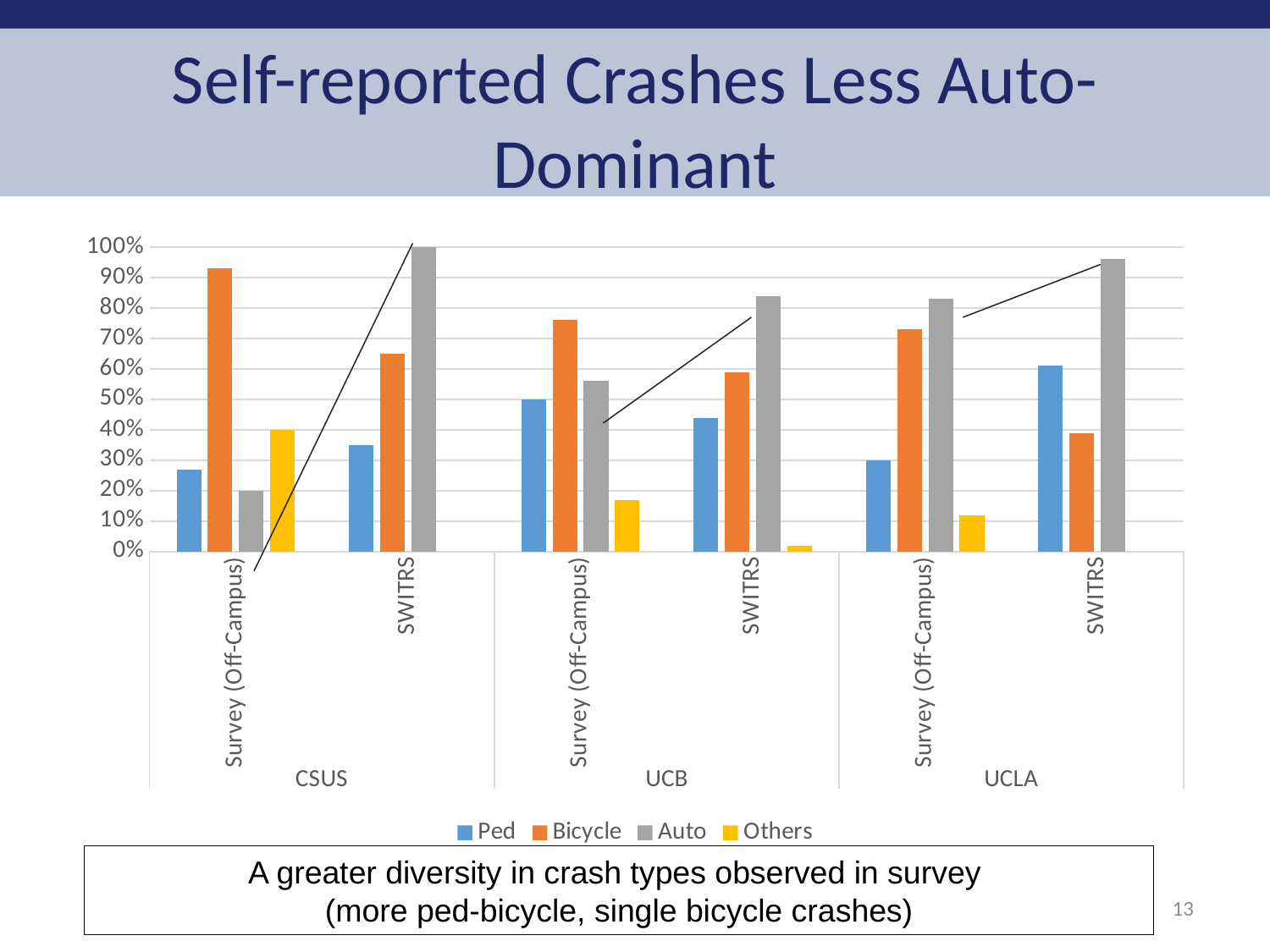
What is the Auto value for SWITRS at CSUS? 100% Which series has the lowest value for SWITRS at UCB? Others What kind of chart is shown on the slide? Bar chart Is the Auto value for SWITRS at UCLA greater or less than 90%? greater Is the Others value for Survey (Off-Campus) at UCLA greater or less than 20%? less Is the Bicycle value for Survey (Off-Campus) at CSUS greater or less than 90%? greater Which colour represents the Auto series in the legend? Gray How many series does the legend list? 4 Which series has the highest value for Survey (Off-Campus) at CSUS? Bicycle How many campuses are shown along the x axis? 3 At UCLA, is the Ped value larger for Survey (Off-Campus) or for SWITRS? SWITRS